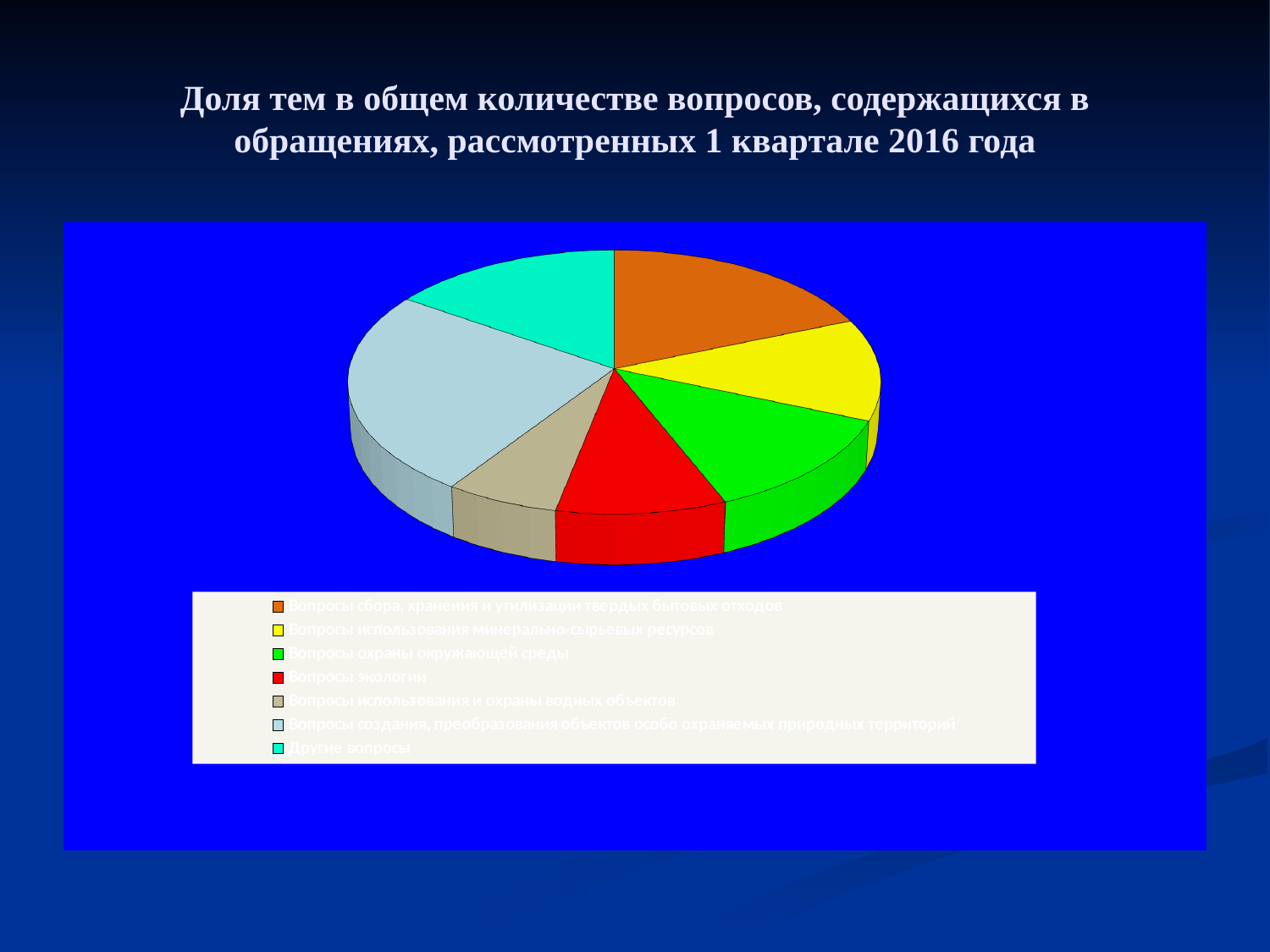
Which category has the smallest slice of the pie? Вопросы использования и охраны водных объектов Which slice is larger: "Вопросы создания, преобразования объектов особо охраняемых природных территорий" or "Вопросы сбора, хранения и утилизации твердых бытовых отходов"? Вопросы создания, преобразования объектов особо охраняемых природных территорий Which colour represents "Другие вопросы" in the pie chart? teal (turquoise) What kind of chart is shown on the slide? pie chart Which slice is larger: "Вопросы экологии" or "Вопросы использования и охраны водных объектов"? Вопросы экологии Which category has the largest slice of the pie? Вопросы создания, преобразования объектов особо охраняемых природных территорий What is the title of the slide containing the pie chart? Доля тем в общем количестве вопросов, содержащихся в обращениях, рассмотренных 1 квартале 2016 года How many slices (categories) does the pie chart have? 7 How many entries does the legend of the pie chart list? 7